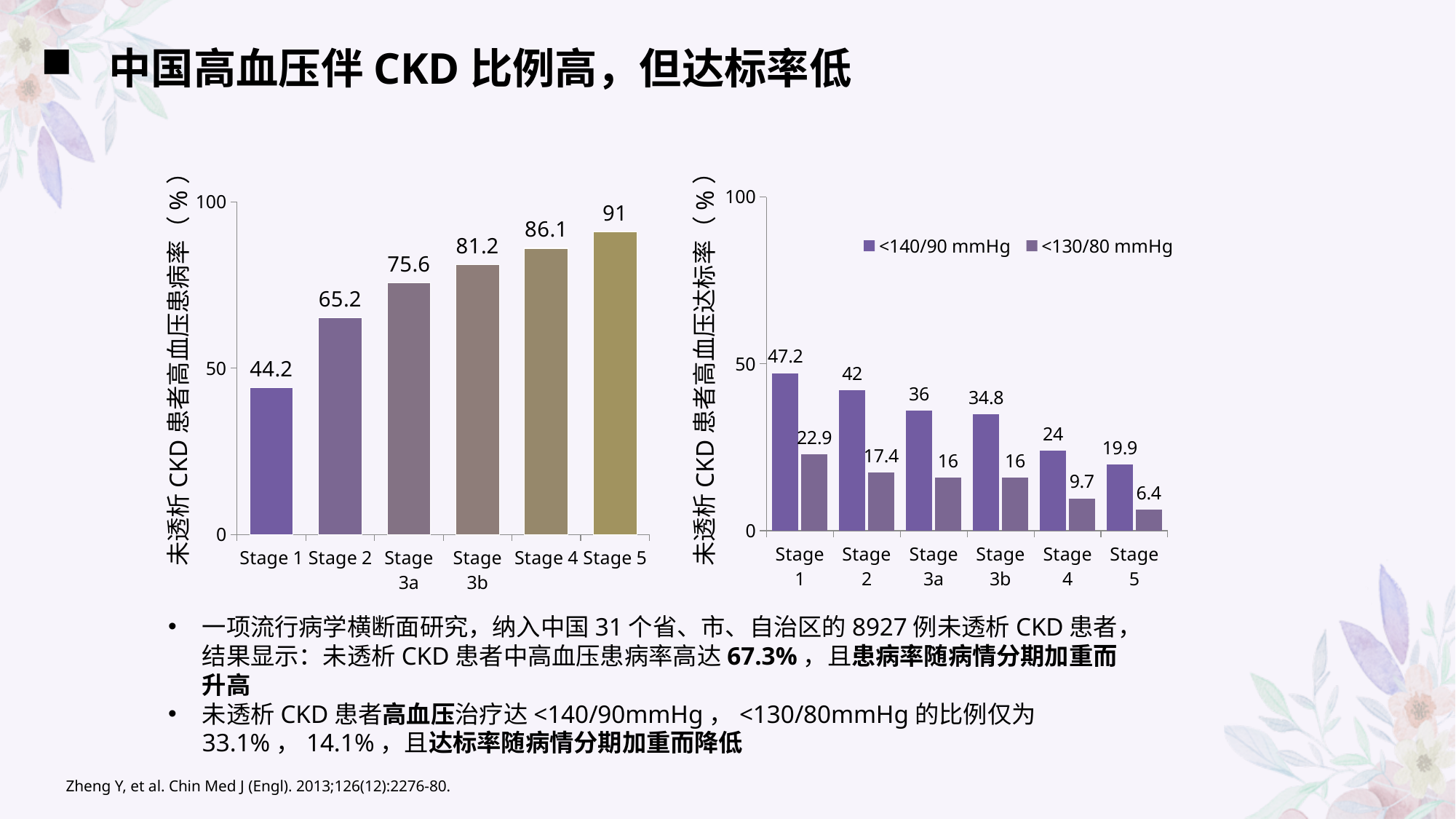
In the left chart, what is the difference between the values for Stage 5 and Stage 1? 46.8 In the left chart, which stage has the highest hypertension prevalence? Stage 5 In the right chart, which is larger for Stage 2: the <140/90 mmHg value or the <130/80 mmHg value? <140/90 mmHg In the right chart, what is the <130/80 mmHg value for Stage 4? 9.7 What type of chart is the left chart? bar chart In the right chart, what is the difference between the <140/90 mmHg and <130/80 mmHg values for Stage 1? 24.3 In the left chart, how many stages are shown on the x axis? 6 In the right chart, what is the <140/90 mmHg value for Stage 3b? 34.8 In the left chart, which stage has the lowest hypertension prevalence? Stage 1 In the right chart, how many series does the legend list? 2 In the left chart, do the values rise or fall from Stage 1 to Stage 5? rise In the left chart, what is the hypertension prevalence for Stage 3a? 75.6